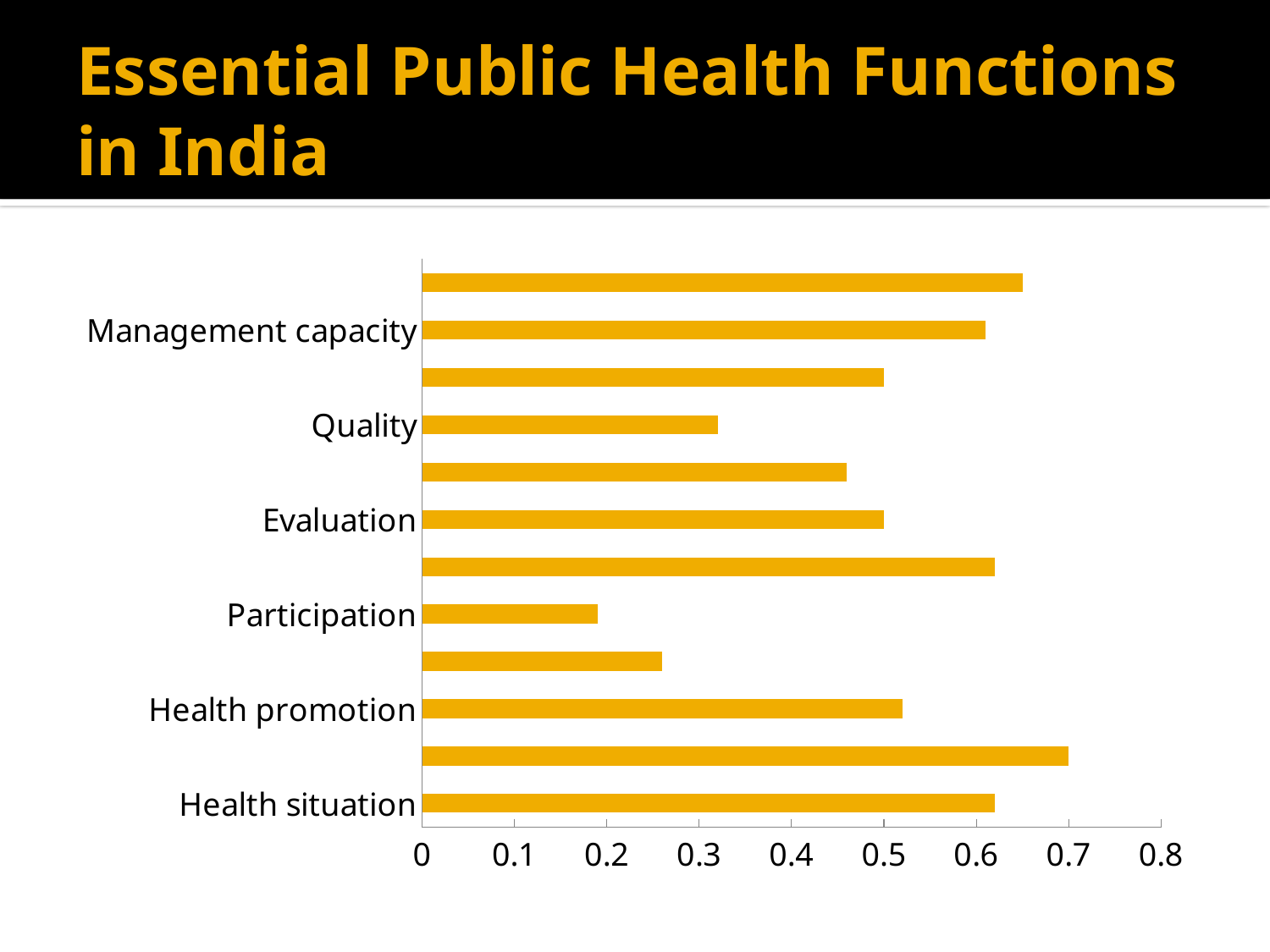
Is the value for Participation greater or less than 0.3? less Is the value for Quality greater or less than 0.4? less Is the value for Health situation greater or less than 0.6? greater How many bars are plotted in the chart? 12 What is the highest value shown on the horizontal axis of the chart? 0.8 What kind of chart is shown on the slide? bar chart How many category labels are readable on the vertical axis of the chart? 6 Which labeled category has the lowest value in the chart? Participation What is the title of the slide containing the chart? Essential Public Health Functions in India Which has the larger value, Quality or Participation? Quality Which has the larger value, Health situation or Health promotion? Health situation